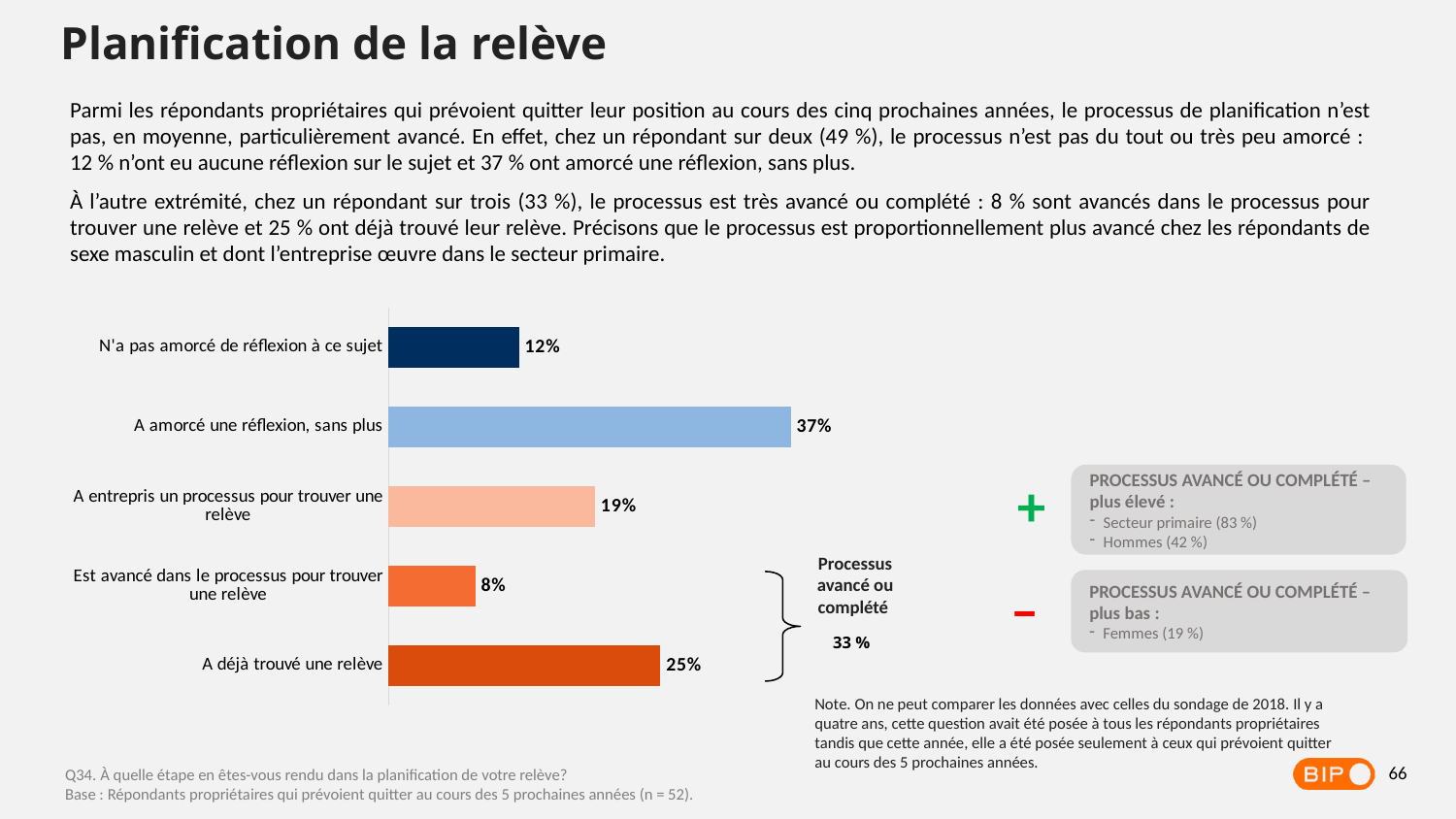
What is the title of the slide containing the chart? Planification de la relève Which category has the highest value in the chart? A amorcé une réflexion, sans plus What is the difference between the values for "A amorcé une réflexion, sans plus" and "A déjà trouvé une relève"? 12% Which category has the lowest value in the chart? Est avancé dans le processus pour trouver une relève What is the value for "Est avancé dans le processus pour trouver une relève"? 8% How many categories are shown in the bar chart? 5 What percentage of respondents have already found a successor ("A déjà trouvé une relève")? 25% Which is larger: the value for "A entrepris un processus pour trouver une relève" or the value for "N'a pas amorcé de réflexion à ce sujet"? A entrepris un processus pour trouver une relève What is the value for "A amorcé une réflexion, sans plus"? 37% What type of chart is shown on the slide? Bar chart What percentage of respondents have not started any reflection on succession ("N'a pas amorcé de réflexion à ce sujet")? 12% What is the combined total for "Est avancé dans le processus pour trouver une relève" and "A déjà trouvé une relève", labelled "Processus avancé ou complété"? 33 %